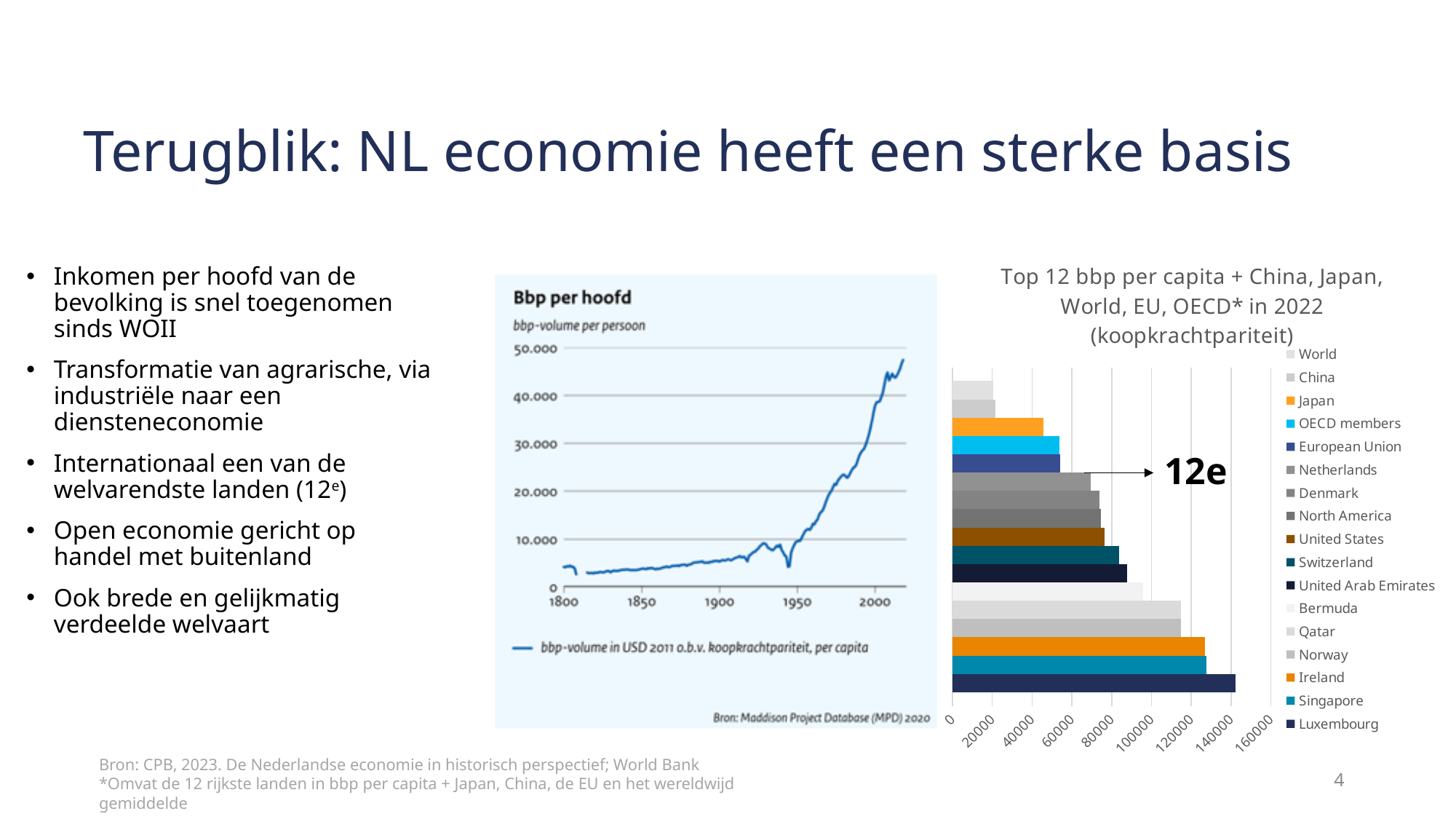
How many entries does the legend of the bar chart on the right list? 17 In the bar chart on the right, is the value for Luxembourg greater or less than 120000? greater In the bar chart on the right, is the value for Netherlands greater or less than 80000? less What kind of chart is the 'Bbp per hoofd' chart on the left? line chart In the bar chart on the right, which is larger, the value for Singapore or the value for Netherlands? Singapore In the 'Bbp per hoofd' line chart on the left, is the value around 1900 greater or less than 10.000? less In the bar chart on the right, which category has the highest value? Luxembourg In the bar chart on the right, which country is marked with the label '12e'? Netherlands In the 'Bbp per hoofd' line chart on the left, does the value rise or fall from 1800 to 2000? rise What kind of chart is the chart on the right titled 'Top 12 bbp per capita + China, Japan, World, EU, OECD* in 2022'? bar chart